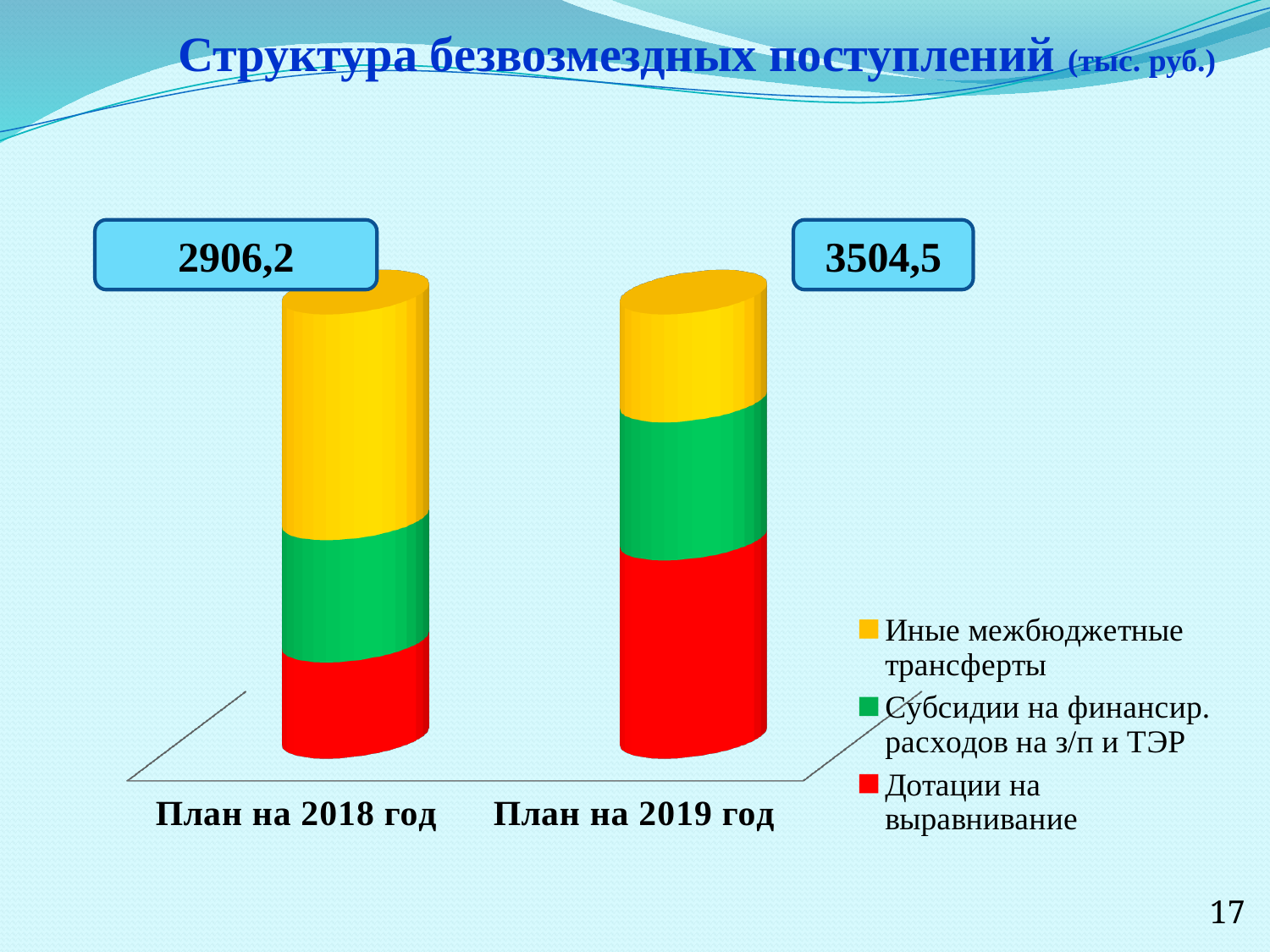
By how much does the total for План на 2019 год exceed the total for План на 2018 год? 598,3 Which series forms the largest segment of the bar for План на 2018 год? Иные межбюджетные трансферты Which category has the higher total, План на 2018 год or План на 2019 год? План на 2019 год What unit is given in the chart title? тыс. руб. Which series is shown in red in the legend? Дотации на выравнивание Do the bar totals rise or fall from План на 2018 год to План на 2019 год? Rise How many series does the legend list? 3 Is the Дотации на выравнивание segment larger in the bar for План на 2018 год or in the bar for План на 2019 год? План на 2019 год How many categories are plotted on the x axis? 2 What is the total value shown for План на 2018 год? 2906,2 What is the total value shown for План на 2019 год? 3504,5 What kind of chart is shown on the slide? Stacked bar chart